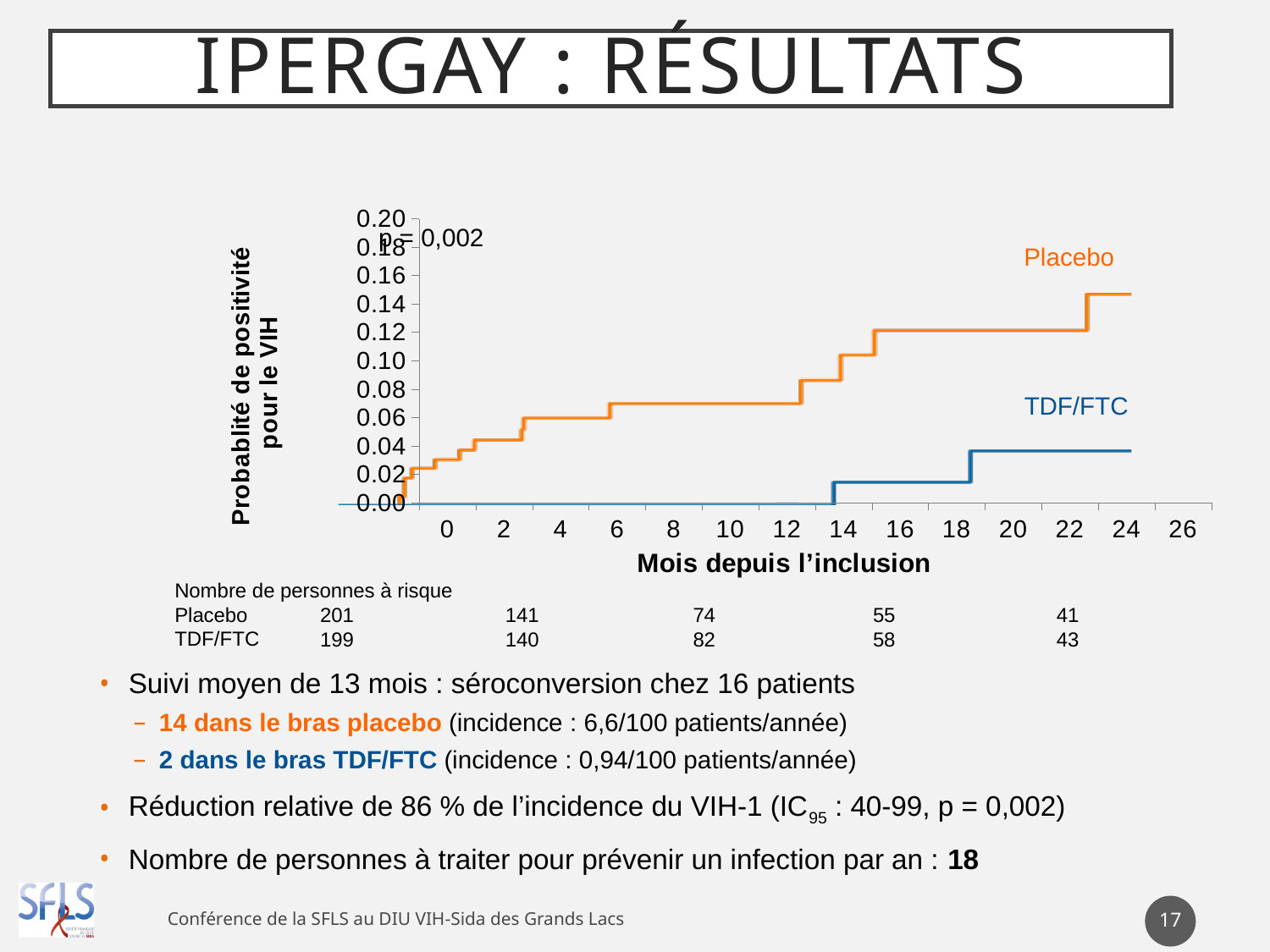
What is the number of persons at risk in the TDF/FTC group in the last column of the table? 43 Is the value for TDF/FTC at month 10 greater or less than 0.02? less Is the value for TDF/FTC at month 24 greater or less than 0.06? less Does the Placebo curve rise or fall as months since inclusion increase? rise What is the difference between the number at risk for Placebo (201) and TDF/FTC (199) in the first column of the table? 2 Is the value for Placebo at month 24 greater or less than 0.12? greater What p-value is printed on the chart? p = 0,002 What kind of chart is shown on the slide? line chart How many series are plotted on the chart? 2 What is the title of the x axis? Mois depuis l'inclusion What is the number of persons at risk in the Placebo group at inclusion (first column of the table)? 201 Which series has the higher probability of HIV positivity at month 24, Placebo or TDF/FTC? Placebo